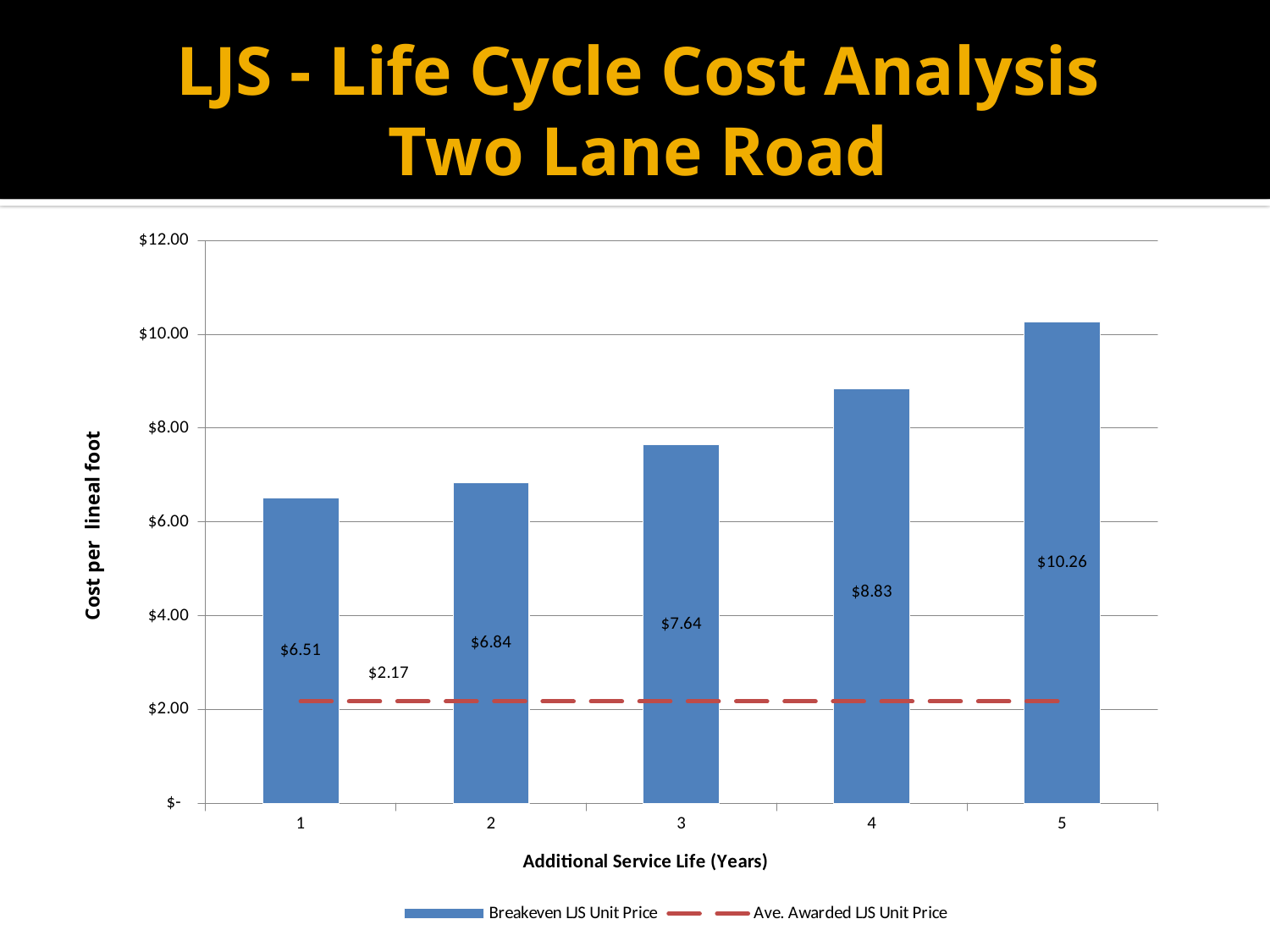
How many series does the legend list? 2 Do the Breakeven LJS Unit Price values rise or fall as additional service life increases? rise What is the Breakeven LJS Unit Price for an additional service life of 1 year? $6.51 Which is larger: the Breakeven LJS Unit Price at 4 years or at 2 years? 4 years What is the difference between the Breakeven LJS Unit Price at 2 years and the Ave. Awarded LJS Unit Price? $4.67 What is the difference between the Breakeven LJS Unit Price at 5 years and at 4 years? $1.43 Is the Breakeven LJS Unit Price at 5 years greater or less than $10.00? greater What is the value of the Ave. Awarded LJS Unit Price line? $2.17 Which additional service life (in years) has the highest Breakeven LJS Unit Price? 5 How many additional service life categories are shown on the x axis? 5 What is the Breakeven LJS Unit Price for an additional service life of 3 years? $7.64 Which additional service life (in years) has the lowest Breakeven LJS Unit Price? 1